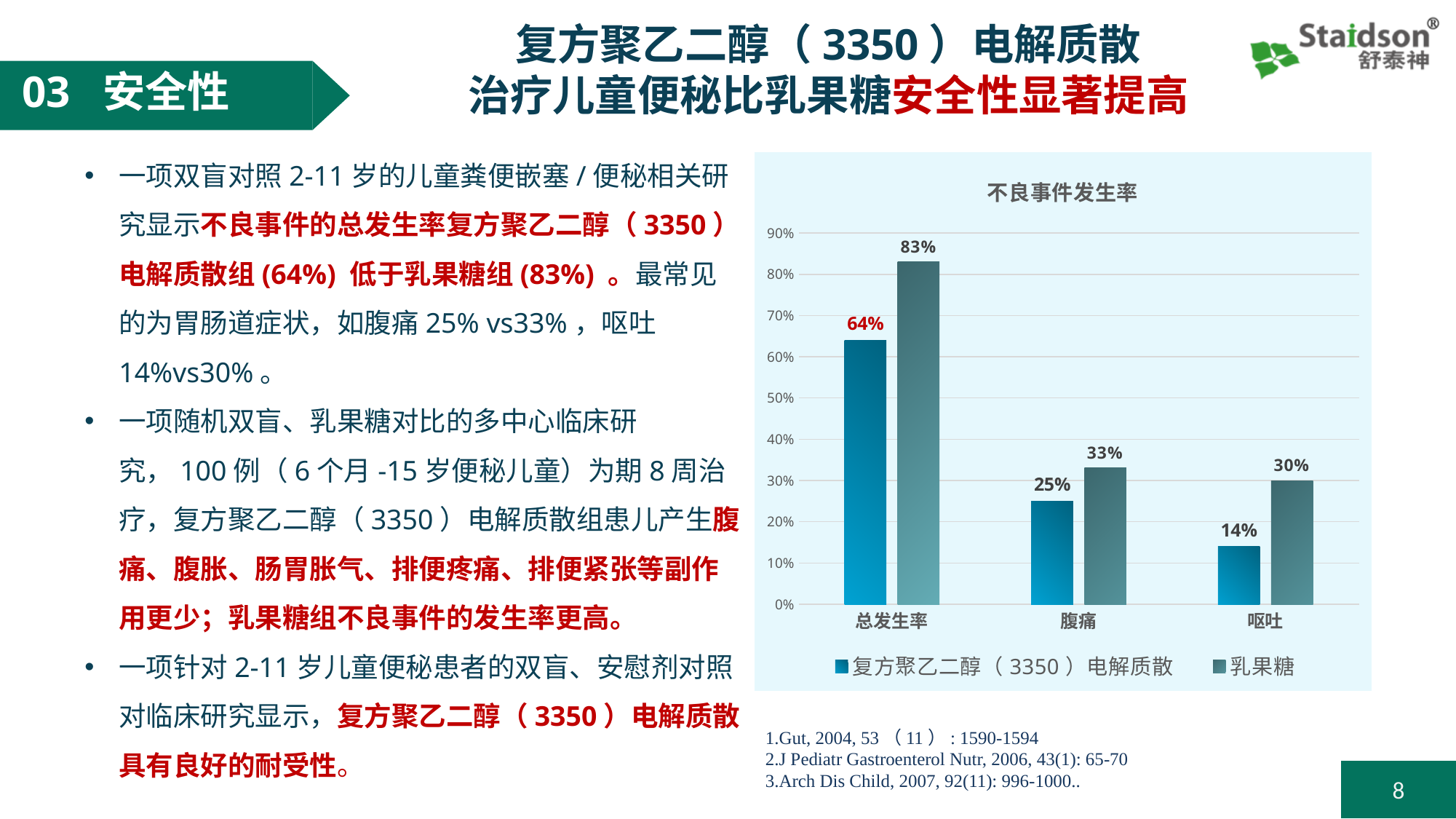
How many series does the chart legend list? 2 What is the title of the chart? 不良事件发生率 In the 腹痛 category, which series has the larger value? 乳果糖 What is the value for 乳果糖 in the 总发生率 category? 83% What is the difference between the 乳果糖 and 复方聚乙二醇（3350）电解质散 values in the 总发生率 category? 19% Which category has the highest value for the 乳果糖 series? 总发生率 Which category has the lowest value for the 复方聚乙二醇（3350）电解质散 series? 呕吐 What is the value for 乳果糖 in the 腹痛 category? 33% What is the value for 复方聚乙二醇（3350）电解质散 in the 呕吐 category? 14% What is the difference between the 乳果糖 and 复方聚乙二醇（3350）电解质散 values in the 呕吐 category? 16% What is the value for 复方聚乙二醇（3350）电解质散 in the 总发生率 category? 64% How many categories are shown on the x axis of the chart? 3